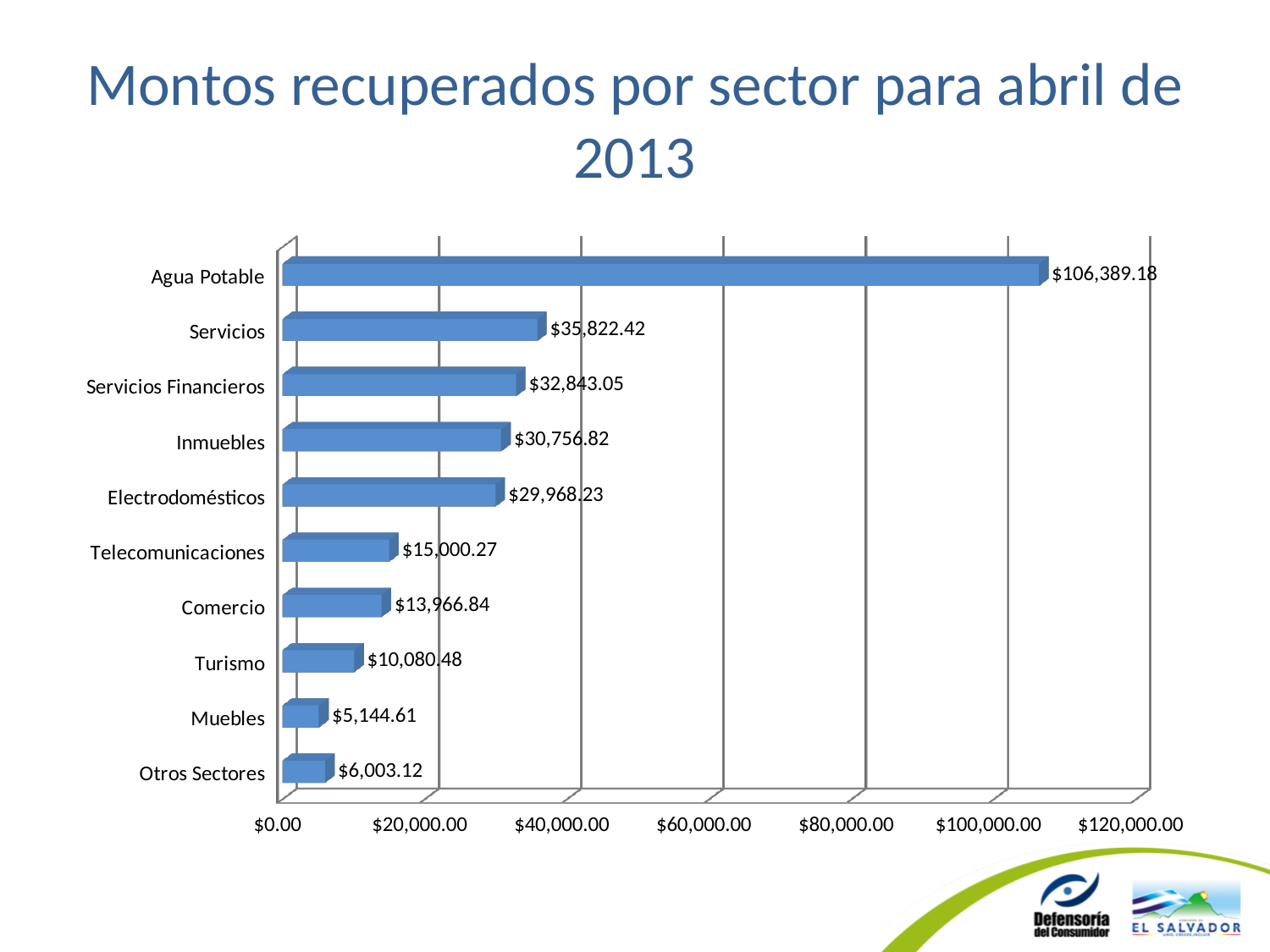
Is the value for Agua Potable greater or less than $100,000.00? greater What kind of chart is shown on the slide? bar chart Which sector has the lowest recovered amount? Muebles What is the value for Agua Potable? $106,389.18 What is the title of the chart? Montos recuperados por sector para abril de 2013 What is the value for Electrodomésticos? $29,968.23 How many sectors are shown in the chart? 10 Which sector has the highest recovered amount? Agua Potable What is the difference between the values for Agua Potable and Servicios? $70,566.76 What is the difference between the values for Otros Sectores and Muebles? $858.51 Which is larger, the value for Servicios or the value for Servicios Financieros? Servicios What is the value for Turismo? $10,080.48